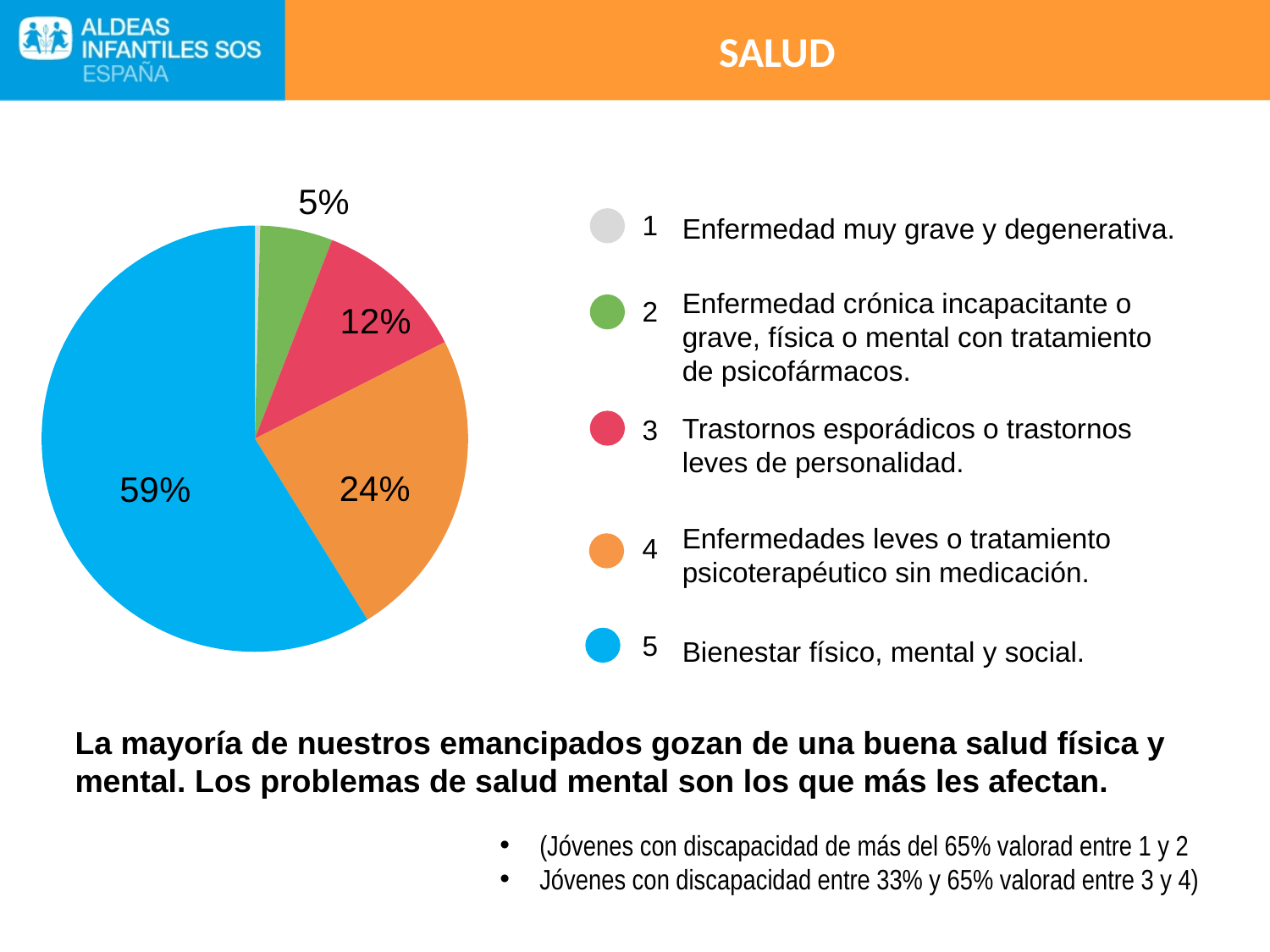
Which category has the smallest slice in the pie chart? 1 – Enfermedad muy grave y degenerativa How many categories does the legend of the pie chart list? 5 What is the title shown in the header of the slide? SALUD Which slice is larger in the pie chart: category 3 or category 4? Category 4 What colour is the slice for category 5 in the pie chart? Blue What type of chart is shown on the slide? Pie chart What percentage does the pie chart show for category 3, "Trastornos esporádicos o trastornos leves de personalidad"? 12% What percentage of the pie chart corresponds to category 5, "Bienestar físico, mental y social"? 59% What percentage does the pie chart show for category 2, "Enfermedad crónica incapacitante o grave"? 5% Which category has the largest slice in the pie chart? 5 – Bienestar físico, mental y social What is the difference in percentage points between the slice for category 5 (59%) and the slice for category 4 (24%)? 35 percentage points What percentage does the pie chart show for category 4, "Enfermedades leves o tratamiento psicoterapéutico sin medicación"? 24%